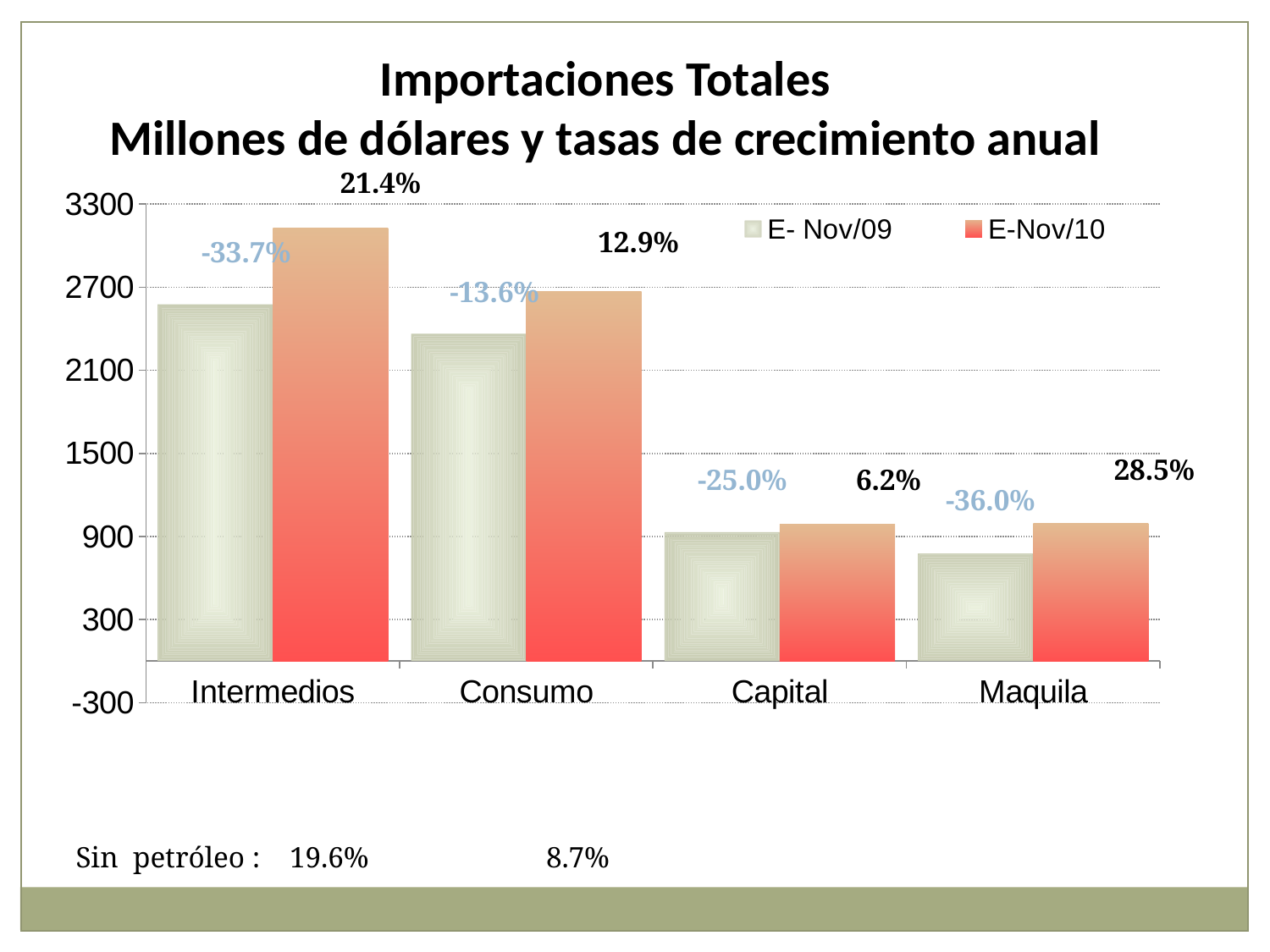
Which is larger, the E- Nov/09 value for Capital or the E- Nov/09 value for Maquila? Capital Is the E-Nov/10 value for Intermedios greater or less than 2700? greater What growth rate is printed above the E-Nov/10 bar for Intermedios? 21.4% What growth rate is printed for Capital in the E-Nov/10 series? 6.2% What kind of chart is shown on the slide? bar chart Which category has the tallest bar in the chart? Intermedios Which category has the highest E-Nov/10 growth rate label? Maquila How many categories are shown on the x axis of the chart? 4 What growth rate is printed for Maquila in the E- Nov/09 series? -36.0% Which category has the lowest E- Nov/09 growth rate label? Maquila Is the E- Nov/09 value for Maquila greater or less than 900? less How many series does the chart's legend list? 2